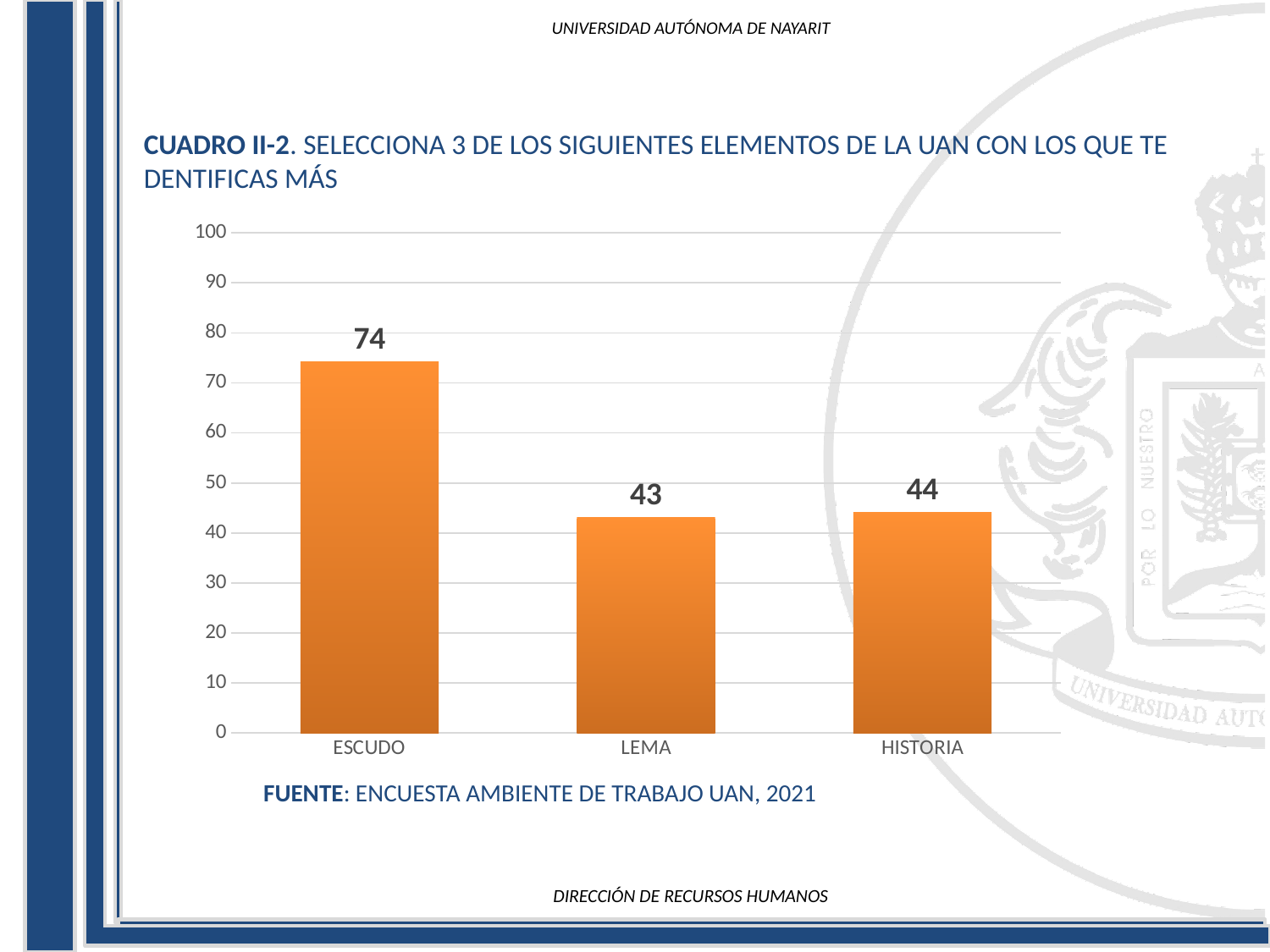
What is the value for ESCUDO? 74 Which category has the lowest value? LEMA What is the difference between the values for ESCUDO and LEMA? 31 How many categories are shown in the chart? 3 What is the value for HISTORIA? 44 What kind of chart is shown on the slide? bar chart What is the difference between the values for HISTORIA and LEMA? 1 Which category has the highest value? ESCUDO What source is cited below the chart? ENCUESTA AMBIENTE DE TRABAJO UAN, 2021 Is the value for ESCUDO greater or less than 70? greater Which is larger, the value for ESCUDO or the value for HISTORIA? ESCUDO What is the value for LEMA? 43